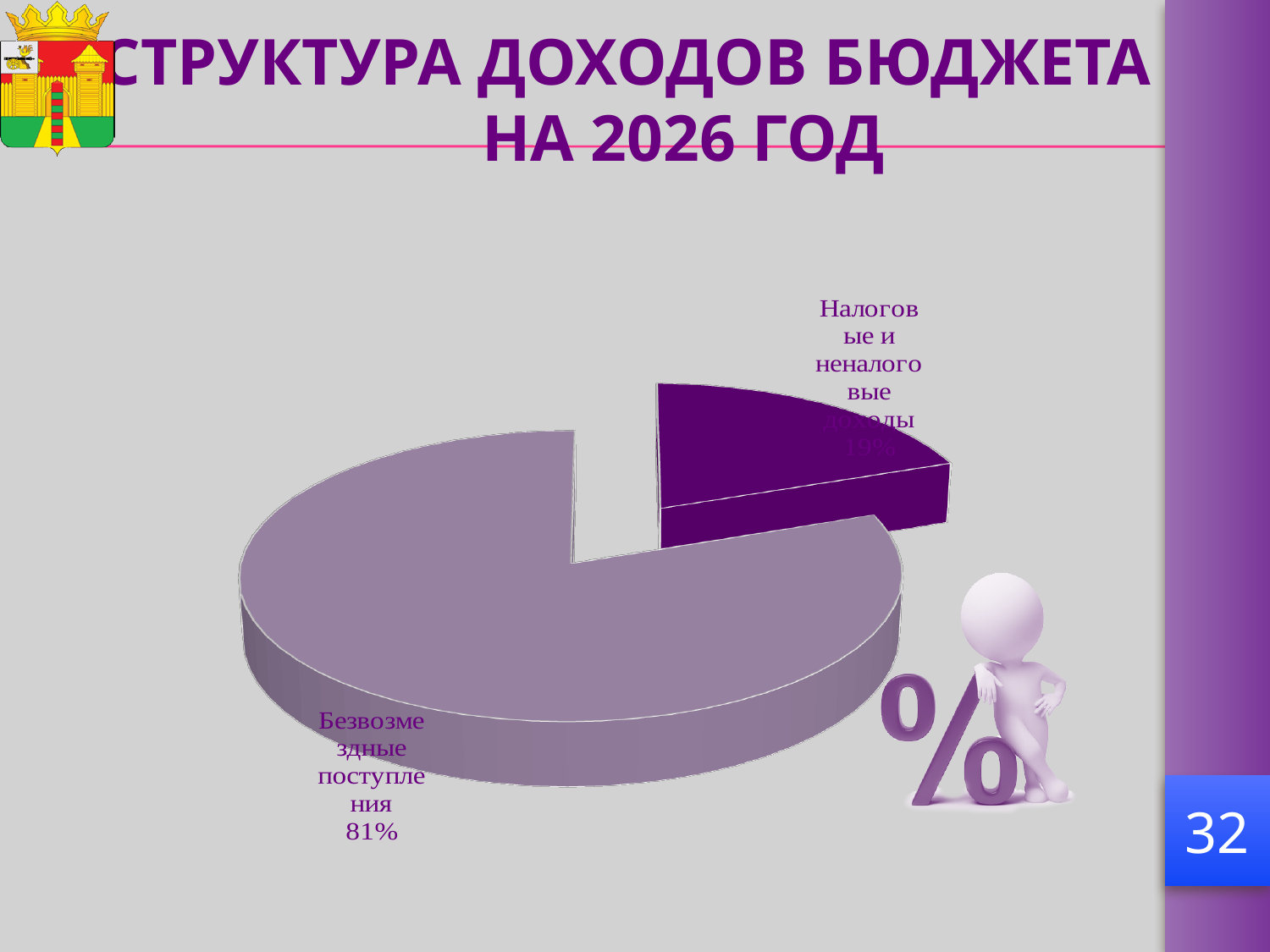
Which slice of the pie chart is pulled out (exploded) from the rest of the pie? Налоговые и неналоговые доходы What share of the pie is labelled "Налоговые и неналоговые доходы"? 19% Which is larger: the share for "Безвозмездные поступления" or the share for "Налоговые и неналоговые доходы"? Безвозмездные поступления Is the share for "Безвозмездные поступления" greater or less than 50%? greater What is the title of the slide containing the pie chart? СТРУКТУРА ДОХОДОВ БЮДЖЕТА НА 2026 ГОД Which slice of the pie chart is the smallest? Налоговые и неналоговые доходы What kind of chart is shown on the slide? Pie chart What is the difference in percentage points between the "Безвозмездные поступления" slice and the "Налоговые и неналоговые доходы" slice? 62 percentage points Which slice of the pie chart is the largest? Безвозмездные поступления How many slices does the pie chart have? 2 What share of the pie is labelled "Безвозмездные поступления"? 81%